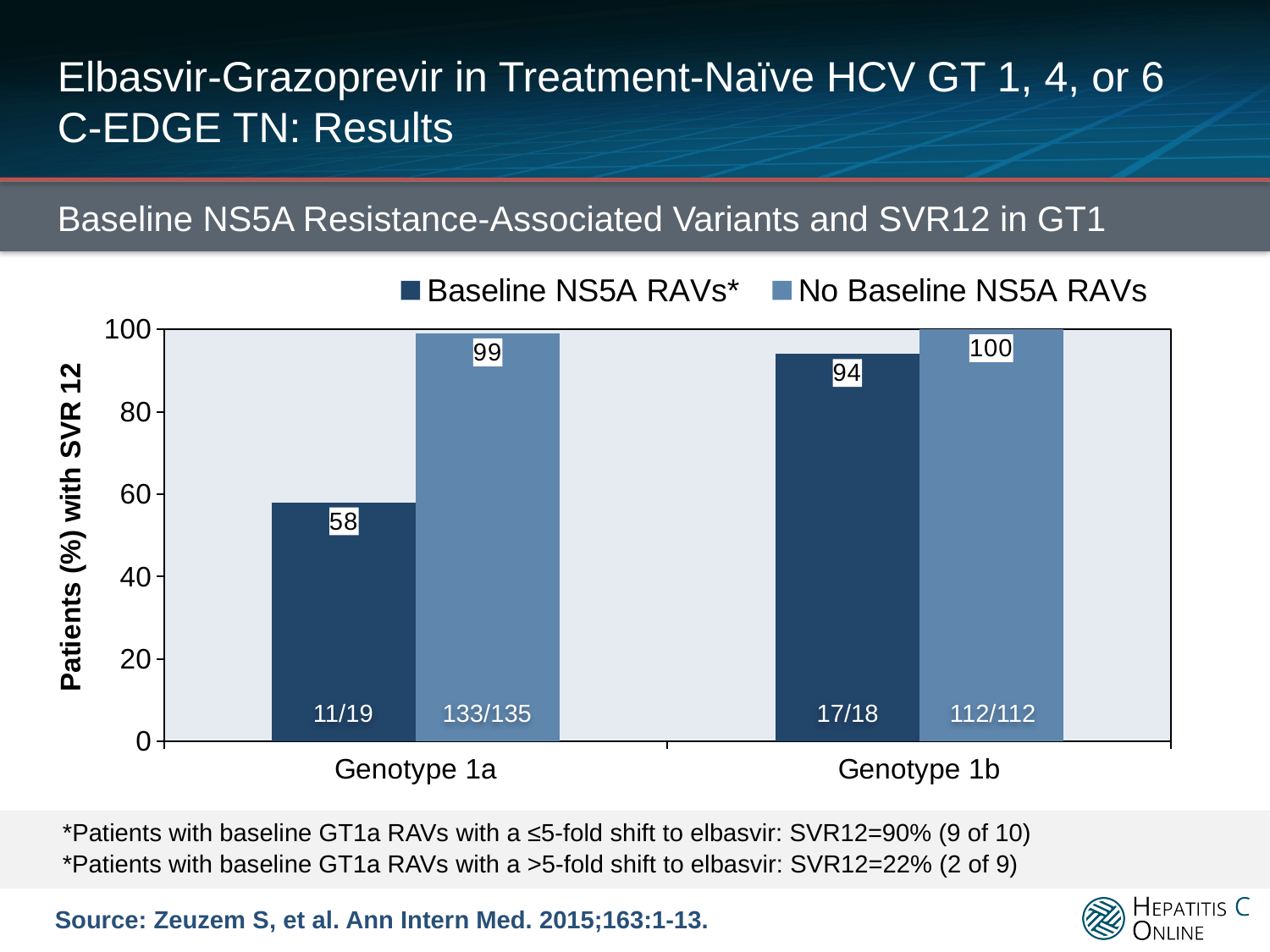
Is the SVR12 value for Baseline NS5A RAVs in Genotype 1a greater or less than 60? less Which is larger: the SVR12 rate for Baseline NS5A RAVs in Genotype 1a or in Genotype 1b? Genotype 1b What is the difference between the SVR12 rates for No Baseline NS5A RAVs and Baseline NS5A RAVs in Genotype 1a? 41 What fraction of patients is shown for No Baseline NS5A RAVs in Genotype 1a? 133/135 How many series does the legend list? 2 Which bar has the highest SVR12 value on the chart? No Baseline NS5A RAVs, Genotype 1b What is the SVR12 rate for patients with Baseline NS5A RAVs in Genotype 1a? 58 What is the SVR12 rate for patients with No Baseline NS5A RAVs in Genotype 1b? 100 How many genotype categories are shown on the x axis? 2 Which bar has the lowest SVR12 value on the chart? Baseline NS5A RAVs, Genotype 1a What kind of chart is shown on the slide? Bar chart What is the SVR12 rate for patients with Baseline NS5A RAVs in Genotype 1b? 94